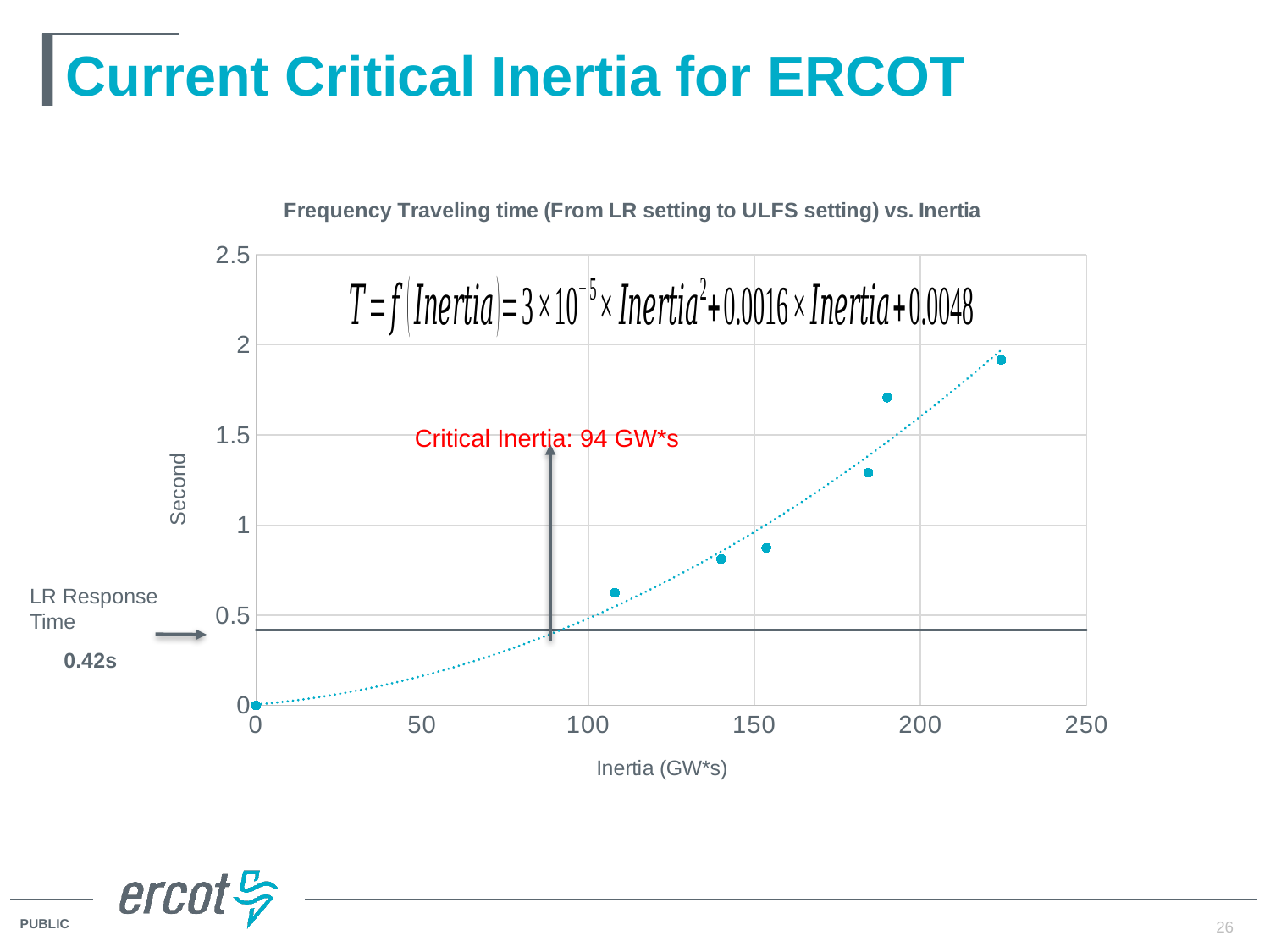
What critical inertia value is annotated on the chart? 94 GW*s What kind of chart is shown on the slide? Scatter chart Which data point has the highest traveling time: the one at roughly 190 GW*s or the one at roughly 184 GW*s? The one at roughly 190 GW*s What is the title of the chart? Frequency Traveling time (From LR setting to ULFS setting) vs. Inertia Do the plotted values rise or fall as inertia increases along the x axis? Rise What is the highest value shown on the y axis of the chart? 2.5 What is the label of the x axis of the chart? Inertia (GW*s) How many data points are plotted on the chart? 7 Is the value for the data point at roughly 225 GW*s inertia greater or less than 1.5 seconds? greater Is the value for the data point at roughly 108 GW*s inertia greater or less than 0.5 seconds? greater Is the value for the data point at roughly 140 GW*s inertia greater or less than 1 second? less What LR Response Time is marked by the horizontal line on the chart? 0.42s